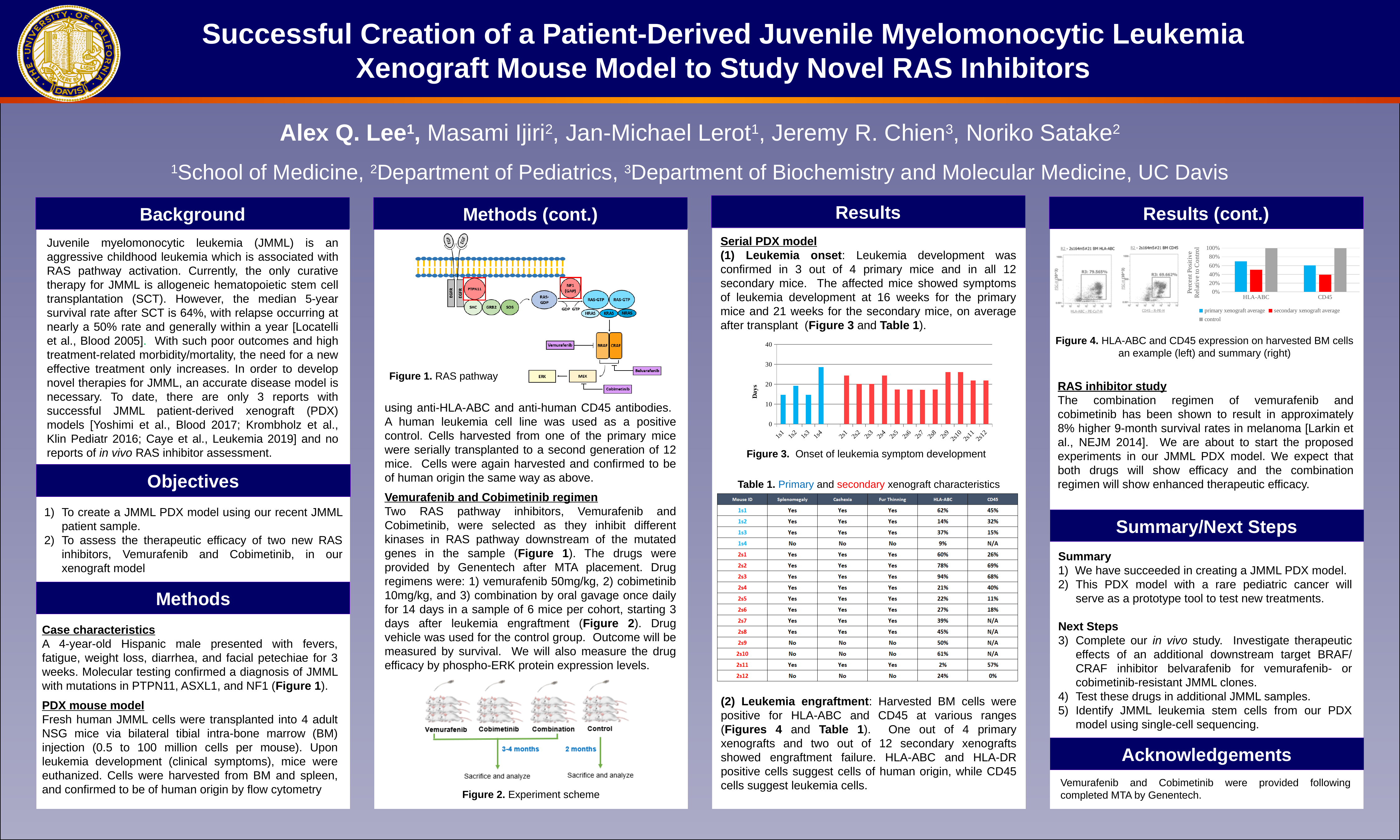
In the Figure 4 bar chart (right), which is larger for HLA-ABC, the primary xenograft average or the secondary xenograft average? primary xenograft average In Figure 3, which mouse has the highest number of days to symptom onset? 1s4 In the Figure 4 bar chart (right), how many series does the legend list? 3 In Figure 3, is the value for 1s4 greater or less than 20 days? greater In Figure 3, is the value for 2s9 greater or less than 20 days? greater In Figure 3, what is the label of the y axis? Days In the Figure 4 bar chart (right), is the secondary xenograft average for CD45 greater or less than 60%? less What kind of chart is Figure 3, Onset of leukemia symptom development? bar chart In Figure 3, which has the larger value, 1s4 or 1s2? 1s4 In the Figure 4 bar chart (right), how many categories are shown on the x axis? 2 In Figure 3, how many mice (categories) are plotted along the x axis? 16